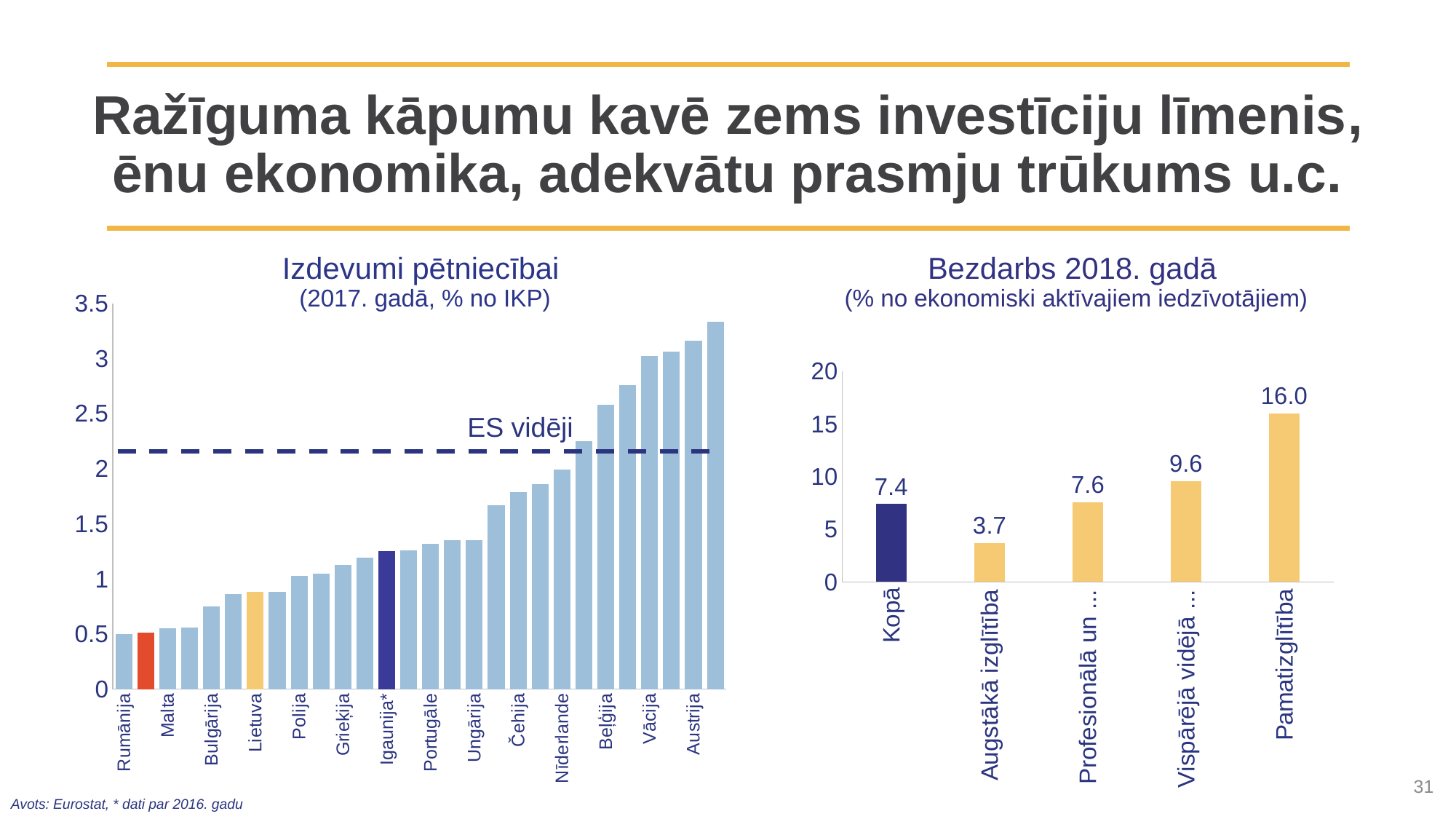
What kind of chart is 'Izdevumi pētniecībai'? bar chart In the chart 'Izdevumi pētniecībai', what does the dashed horizontal line represent? ES vidēji In the chart 'Izdevumi pētniecībai', is the value for Lietuva greater or less than 1? less In the chart 'Bezdarbs 2018. gadā', which category has the highest value? Pamatizglītība In the chart 'Izdevumi pētniecībai', is the value for Austrija greater or less than 3? greater How many categories are shown in the chart 'Bezdarbs 2018. gadā'? 5 In the chart 'Bezdarbs 2018. gadā', what is the difference between the values for Pamatizglītība and Augstākā izglītība? 12.3 In the chart 'Bezdarbs 2018. gadā', what is the value for Kopā? 7.4 In the chart 'Izdevumi pētniecībai', do the bar values rise or fall from left to right along the x axis? rise In the chart 'Bezdarbs 2018. gadā', which category has the lowest value? Augstākā izglītība In the chart 'Bezdarbs 2018. gadā', what is the value for Pamatizglītība? 16.0 In the chart 'Bezdarbs 2018. gadā', which is larger: the value for Vispārējā vidējā ... or for Profesionālā un ...? Vispārējā vidējā ...